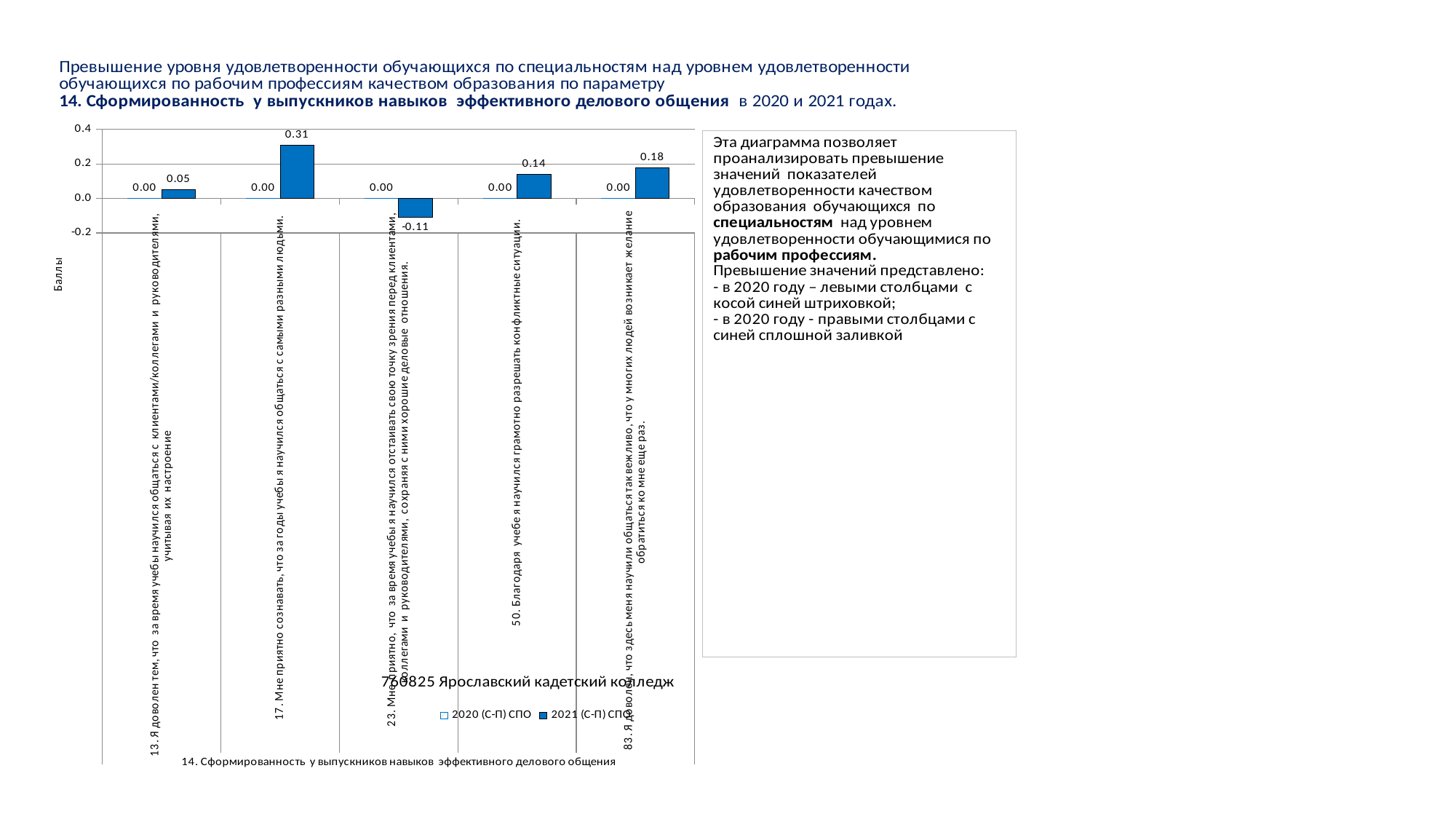
What is the label of the vertical axis? Баллы How many series does the chart legend list? 2 What is the 2021 (С-П) СПО value for statement 50 ("Благодаря учебе я научился грамотно разрешать конфликтные ситуации")? 0.14 What is the difference between the 2021 (С-П) СПО values for statement 17 and statement 83? 0.13 What is the 2021 (С-П) СПО value for statement 23? -0.11 Which statement has the highest 2021 (С-П) СПО value? 17 Which statement has the lowest 2021 (С-П) СПО value? 23 What type of chart is shown on the slide? bar chart What is the 2021 (С-П) СПО value for statement 17 ("Мне приятно сознавать, что за годы учебы я научился общаться с самыми разными людьми")? 0.31 What is the 2020 (С-П) СПО value for statement 13? 0.00 How many categories (statements) are plotted on the chart? 5 Which is larger: the 2021 (С-П) СПО value for statement 50 or for statement 83? statement 83